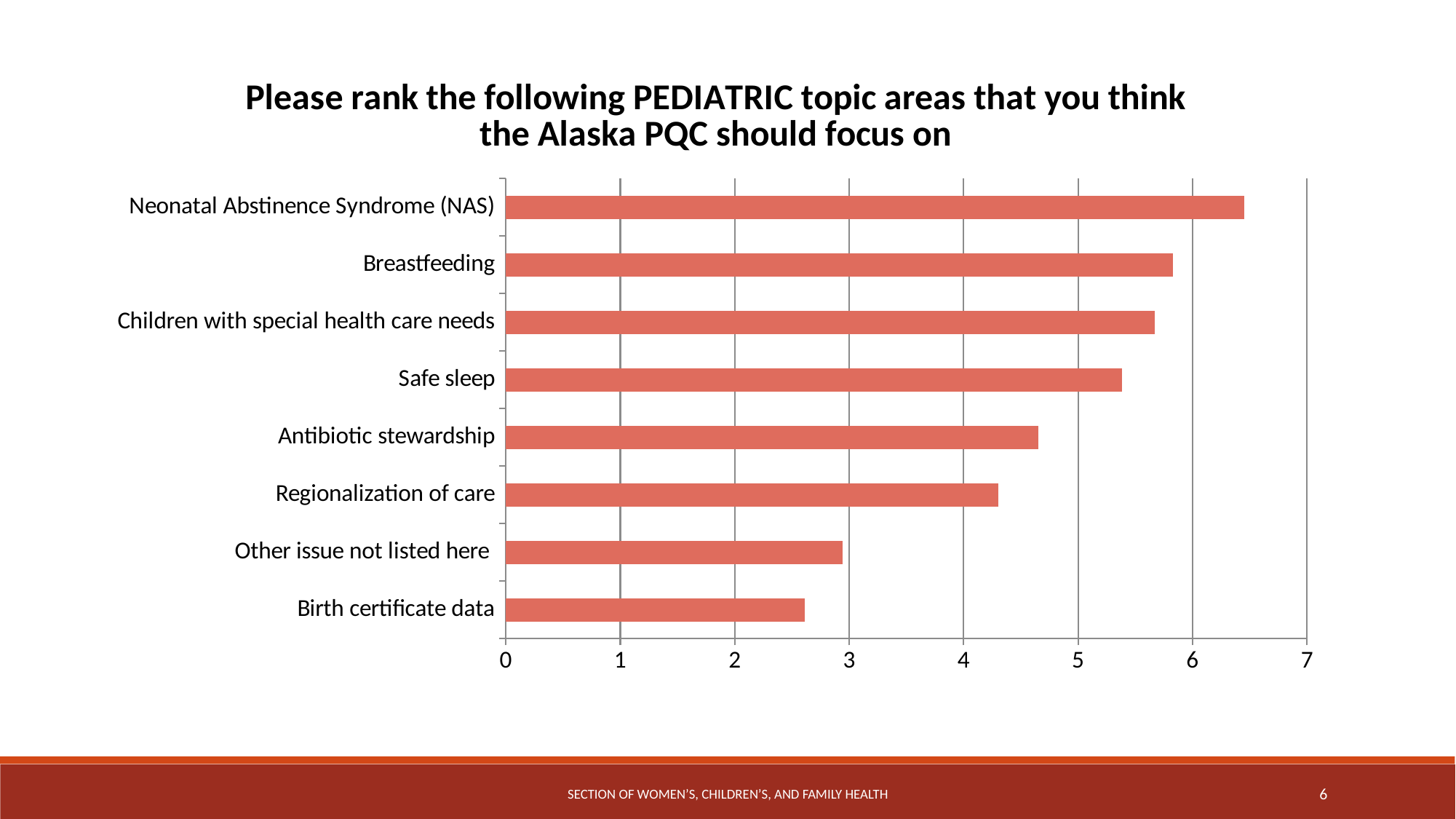
Is the value for Safe sleep greater or less than 5? greater Which topic area has the highest value? Neonatal Abstinence Syndrome (NAS) What is the maximum value shown on the horizontal axis? 7 Is the value for Antibiotic stewardship greater or less than 4? greater Which has a larger value, Safe sleep or Regionalization of care? Safe sleep How many topic areas are plotted in the chart? 8 Is the value for Breastfeeding greater or less than 6? less What kind of chart is shown on the slide? bar chart Which topic area has the lowest value? Birth certificate data Which has a larger value, Other issue not listed here or Antibiotic stewardship? Antibiotic stewardship